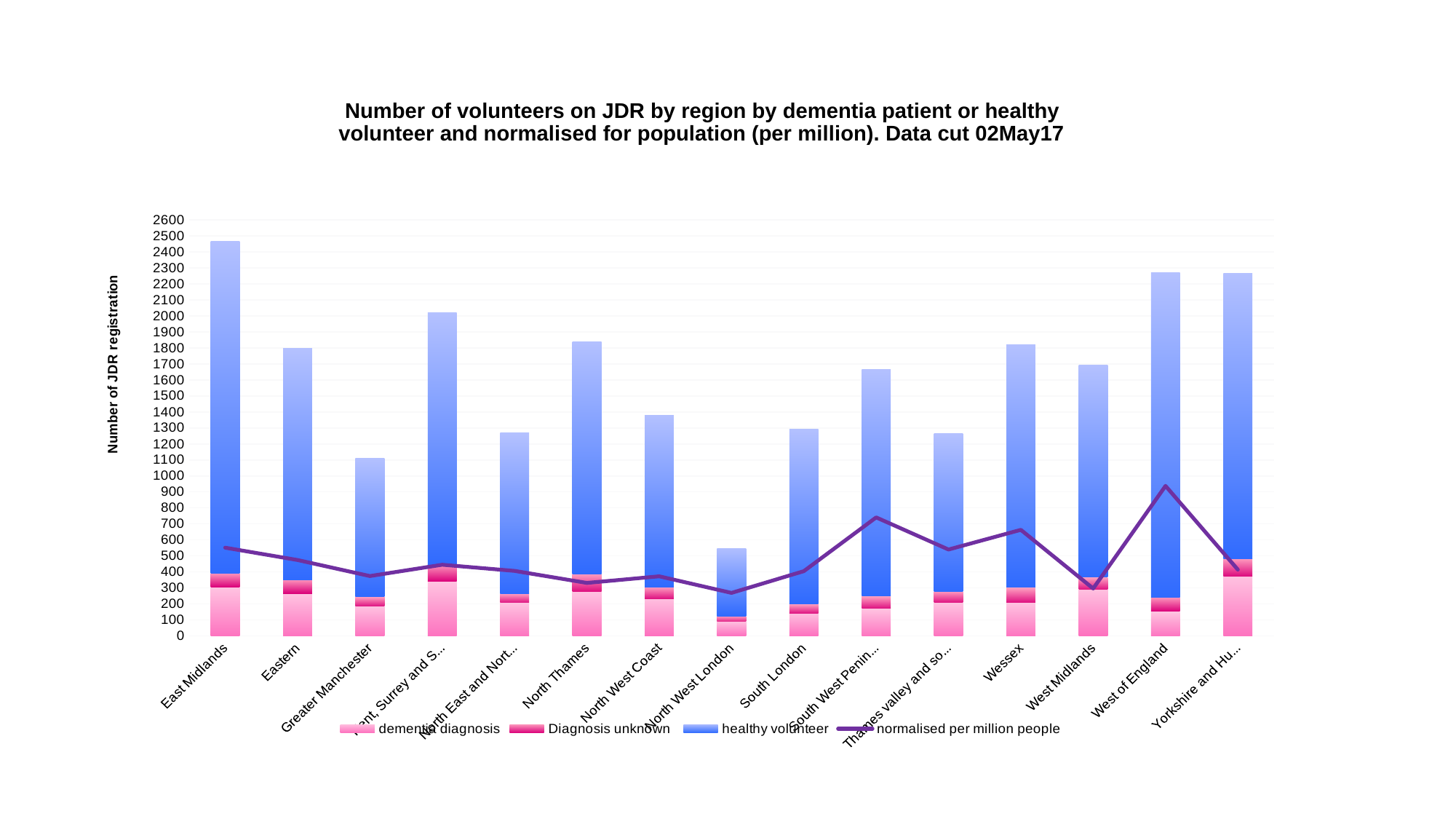
Which region has the tallest stacked bar (most JDR registrations)? East Midlands Which has the taller stacked bar, East Midlands or Eastern? East Midlands Is the 'normalised per million people' value for West of England greater or less than 900? greater How many series does the legend list? 4 Is the total stacked bar for Greater Manchester greater or less than 1000? greater Which region has the shortest stacked bar (fewest JDR registrations)? North West London What kind of chart is shown on the slide? Stacked bar chart with a line Is the total stacked bar for North West London greater or less than 600? less How many regions are shown along the x axis? 15 What is the label of the y axis? Number of JDR registration Which region has the highest value on the 'normalised per million people' line? West of England